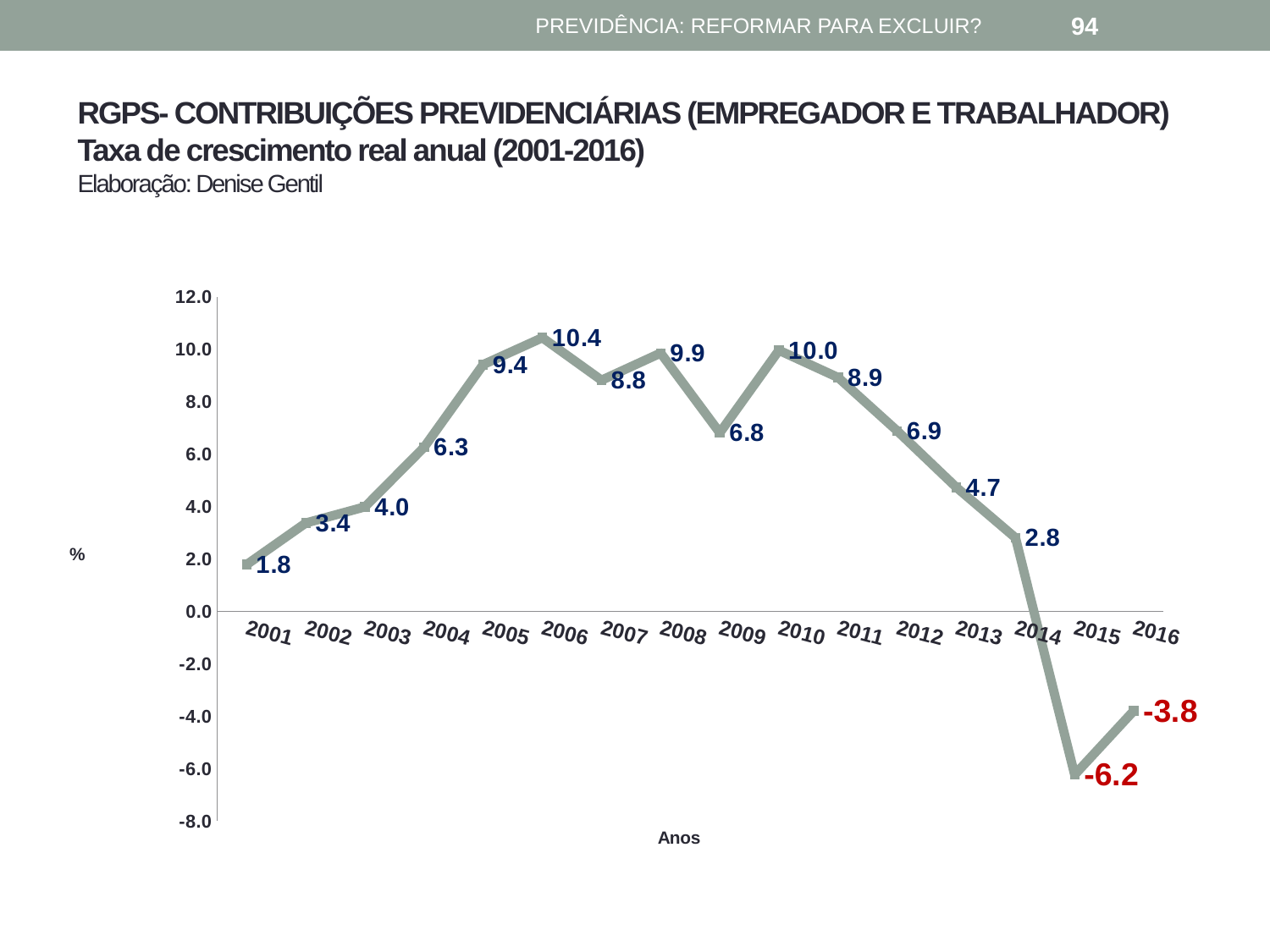
How many years are plotted on the chart? 16 What is the real annual growth rate shown for 2006? 10.4 What type of chart is shown on the slide? Line chart What is the value shown for 2001? 1.8 What is the label of the horizontal axis? Anos Which year has the lowest value on the chart? 2015 Which year has the highest growth rate on the chart? 2006 Which year has the larger value, 2008 or 2007? 2008 What is the difference between the values for 2010 and 2009? 3.2 What value is plotted for 2015? -6.2 Do the values rise or fall from 2011 to 2015? Fall What is the difference between the values for 2016 and 2015? 2.4